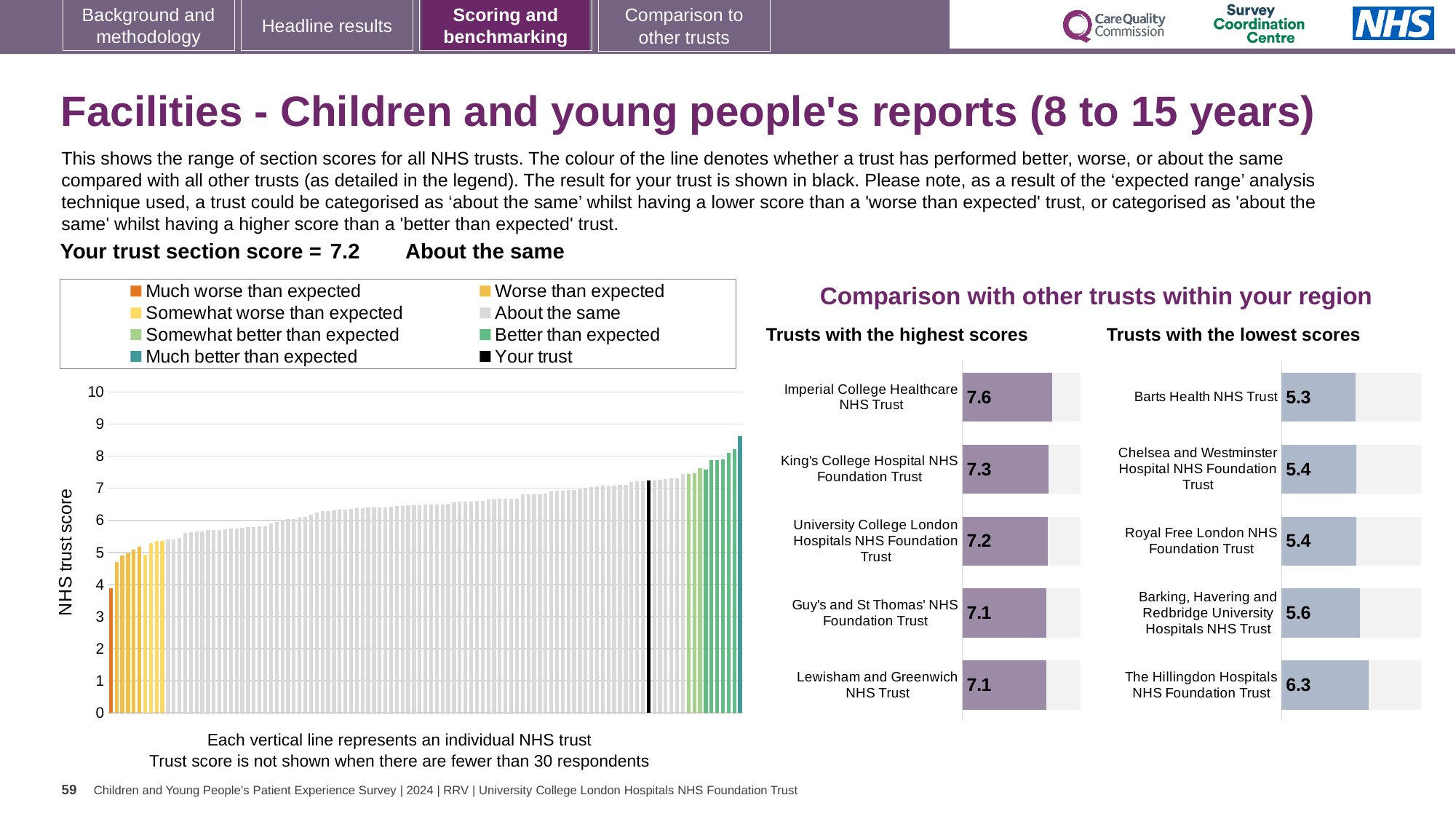
How many trusts are shown in the 'Trusts with the lowest scores' chart? 5 What kind of chart is the NHS trust score chart on the left of the slide? Bar chart In the 'Trusts with the lowest scores' chart, what is the score for The Hillingdon Hospitals NHS Foundation Trust? 6.3 In the 'Trusts with the highest scores' chart, what is the difference between the scores of Imperial College Healthcare NHS Trust and King's College Hospital NHS Foundation Trust? 0.3 In the 'Trusts with the highest scores' chart, what is the score for Imperial College Healthcare NHS Trust? 7.6 In the 'Trusts with the highest scores' chart, what is the score for King's College Hospital NHS Foundation Trust? 7.3 How many entries does the legend of the NHS trust score chart on the left list? 8 In the 'Trusts with the lowest scores' chart, which trust has the lowest score? Barts Health NHS Trust In the NHS trust score chart on the left, do the values rise or fall from left to right along the x axis? Rise In the 'Trusts with the lowest scores' chart, what is the difference between the scores of The Hillingdon Hospitals NHS Foundation Trust and Barts Health NHS Trust? 1.0 In the 'Trusts with the lowest scores' chart, which has the higher score: Barking, Havering and Redbridge University Hospitals NHS Trust or Chelsea and Westminster Hospital NHS Foundation Trust? Barking, Havering and Redbridge University Hospitals NHS Trust In the 'Trusts with the highest scores' chart, which trust has the highest score? Imperial College Healthcare NHS Trust